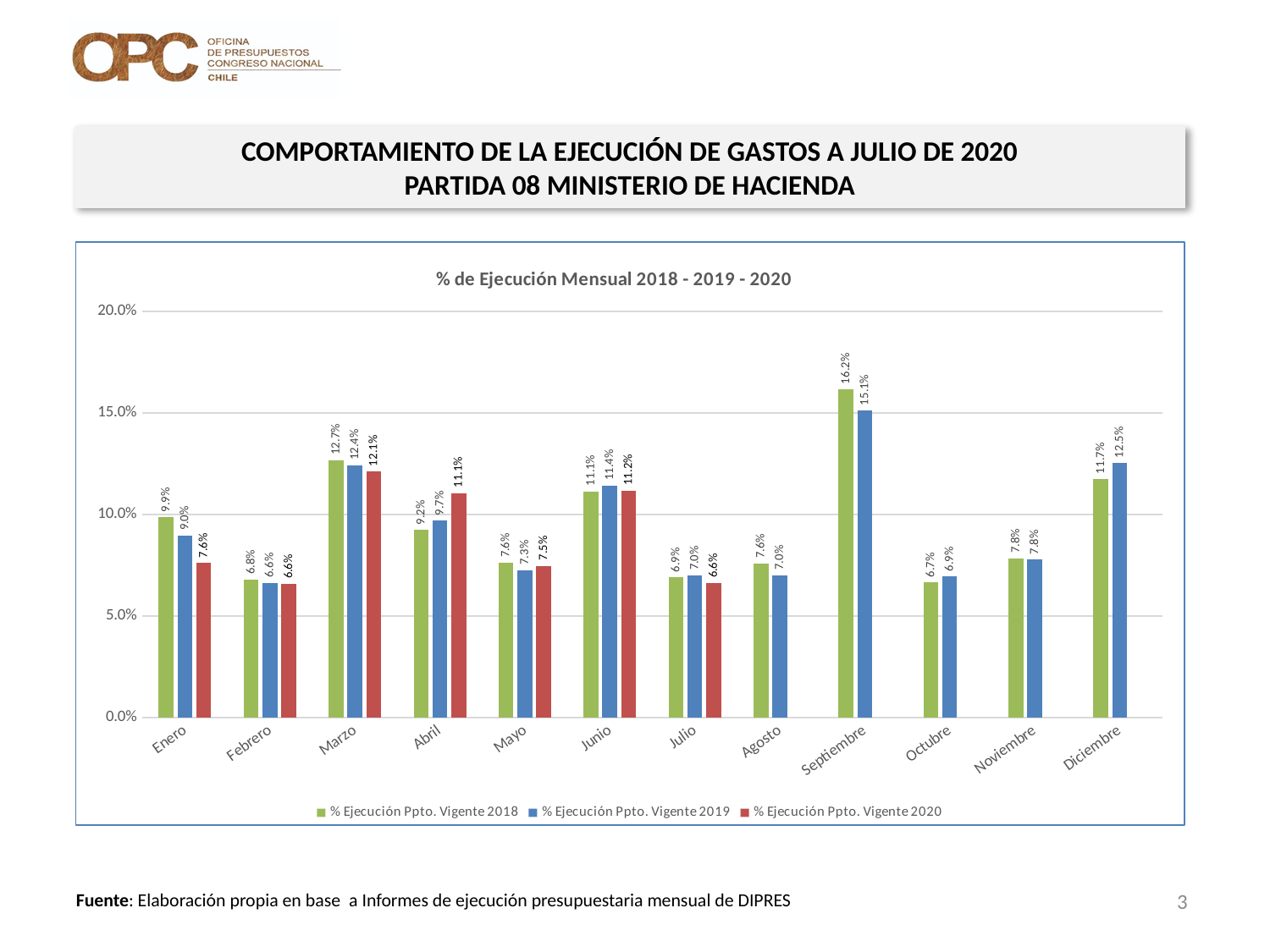
How many series does the legend list? 3 What is the value for % Ejecución Ppto. Vigente 2020 in Abril? 11.1% What is the difference between the 2018 and 2019 values in Septiembre? 1.1% Which month has the highest value for % Ejecución Ppto. Vigente 2018? Septiembre Which month has the lowest value for % Ejecución Ppto. Vigente 2020? Febrero and Julio (6.6%) In Enero, which is larger: the 2018 value or the 2020 value? 2018 (9.9%) How many months are shown on the x axis? 12 What is the value for % Ejecución Ppto. Vigente 2019 in Diciembre? 12.5% Is the value for % Ejecución Ppto. Vigente 2018 in Marzo greater or less than 10.0%? greater What is the value for % Ejecución Ppto. Vigente 2018 in Septiembre? 16.2% What is the title of the chart? % de Ejecución Mensual 2018 - 2019 - 2020 What kind of chart is shown on the slide? Bar chart